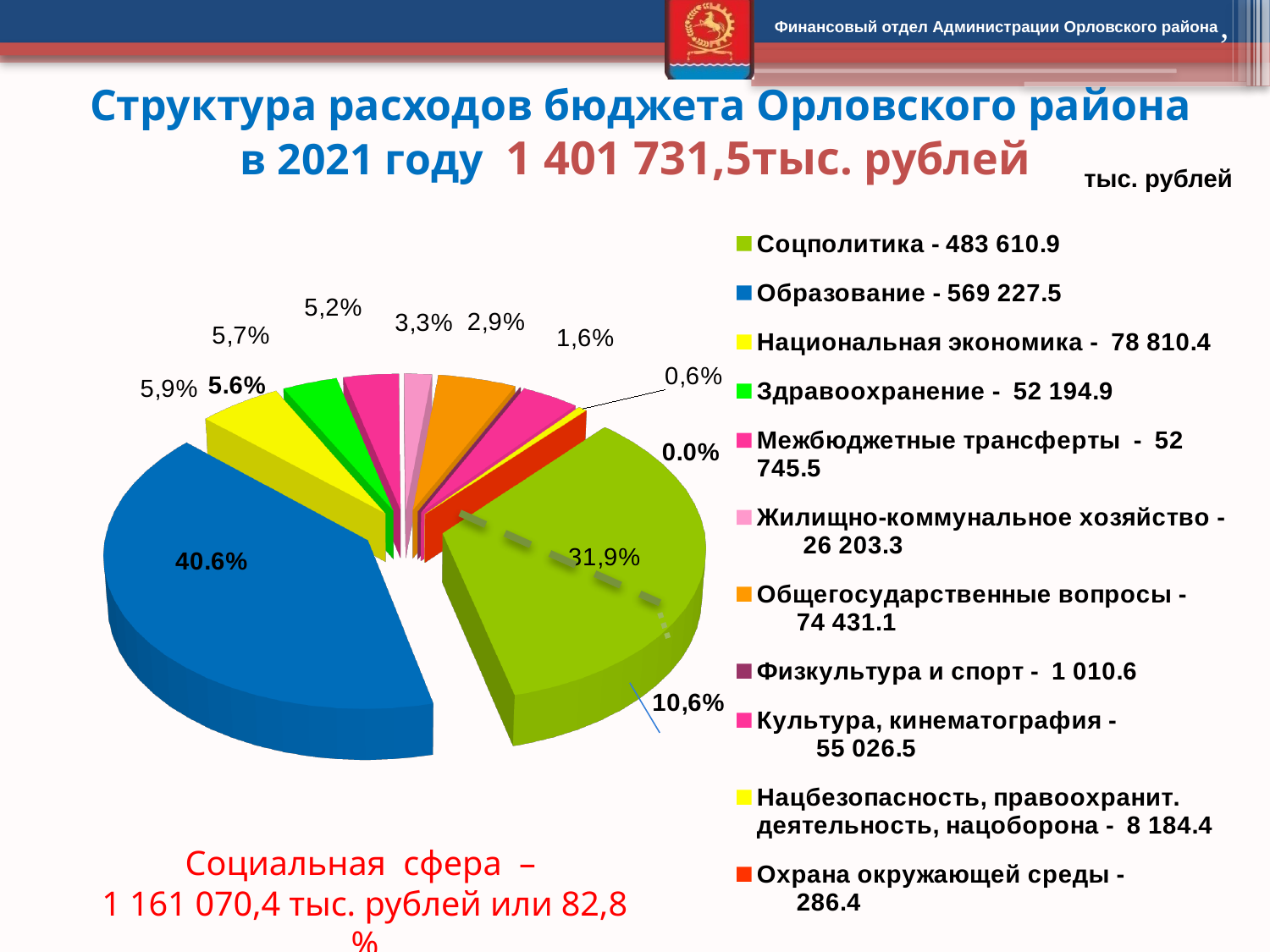
Which category has the largest value in the pie chart? Образование What is the value for Культура, кинематография shown in the legend? 55 026.5 What kind of chart is shown on the slide? pie chart What percentage share of the pie is labelled on the Образование (blue) slice? 40.6% Which is larger: Национальная экономика or Общегосударственные вопросы? Национальная экономика What is the difference between the values for Образование and Соцполитика? 85 616.6 What total amount of budget expenditure is stated in the chart title for 2021? 1 401 731,5 тыс. рублей Which category has the smallest value in the pie chart? Охрана окружающей среды What is the value for Образование shown in the legend? 569 227.5 How many categories does the legend of the pie chart list? 11 What is the value for Охрана окружающей среды shown in the legend? 286.4 What is the value for Соцполитика shown in the legend? 483 610.9